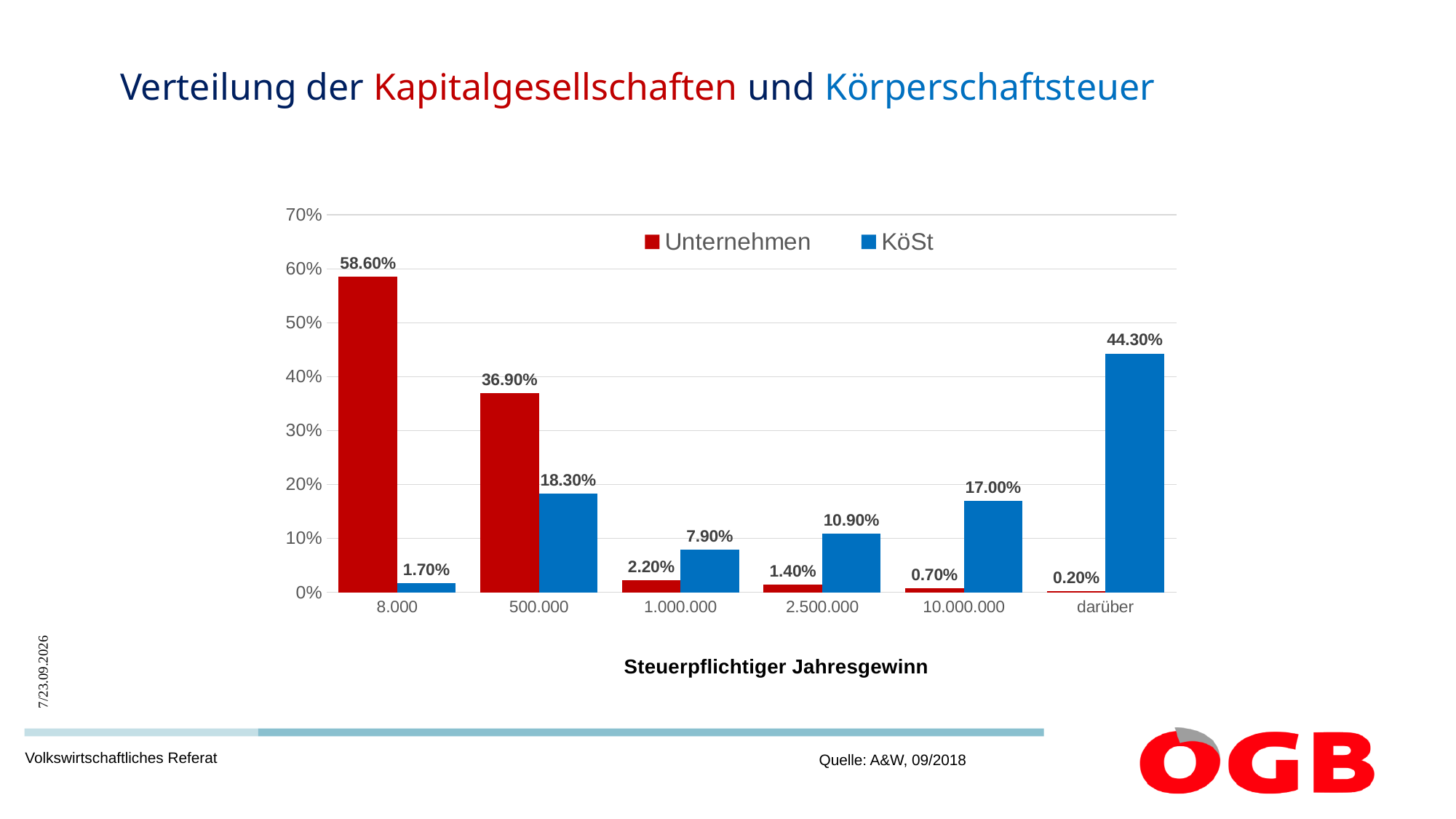
For the 10.000.000 category, which series has the larger value, Unternehmen or KöSt? KöSt Which category has the lowest Unternehmen value? darüber Is the KöSt value for 1.000.000 greater or less than 10%? less Which category has the highest KöSt value? darüber What is the x-axis title of the chart? Steuerpflichtiger Jahresgewinn What kind of chart is shown on the slide? bar chart What is the KöSt value for the 2.500.000 category? 10.90% How many series does the legend list? 2 What is the Unternehmen value for the 8.000 category? 58.60% What is the difference between the Unternehmen and KöSt values for the 500.000 category? 18.60% How many categories are shown on the x axis? 6 What is the KöSt value for the darüber category? 44.30%